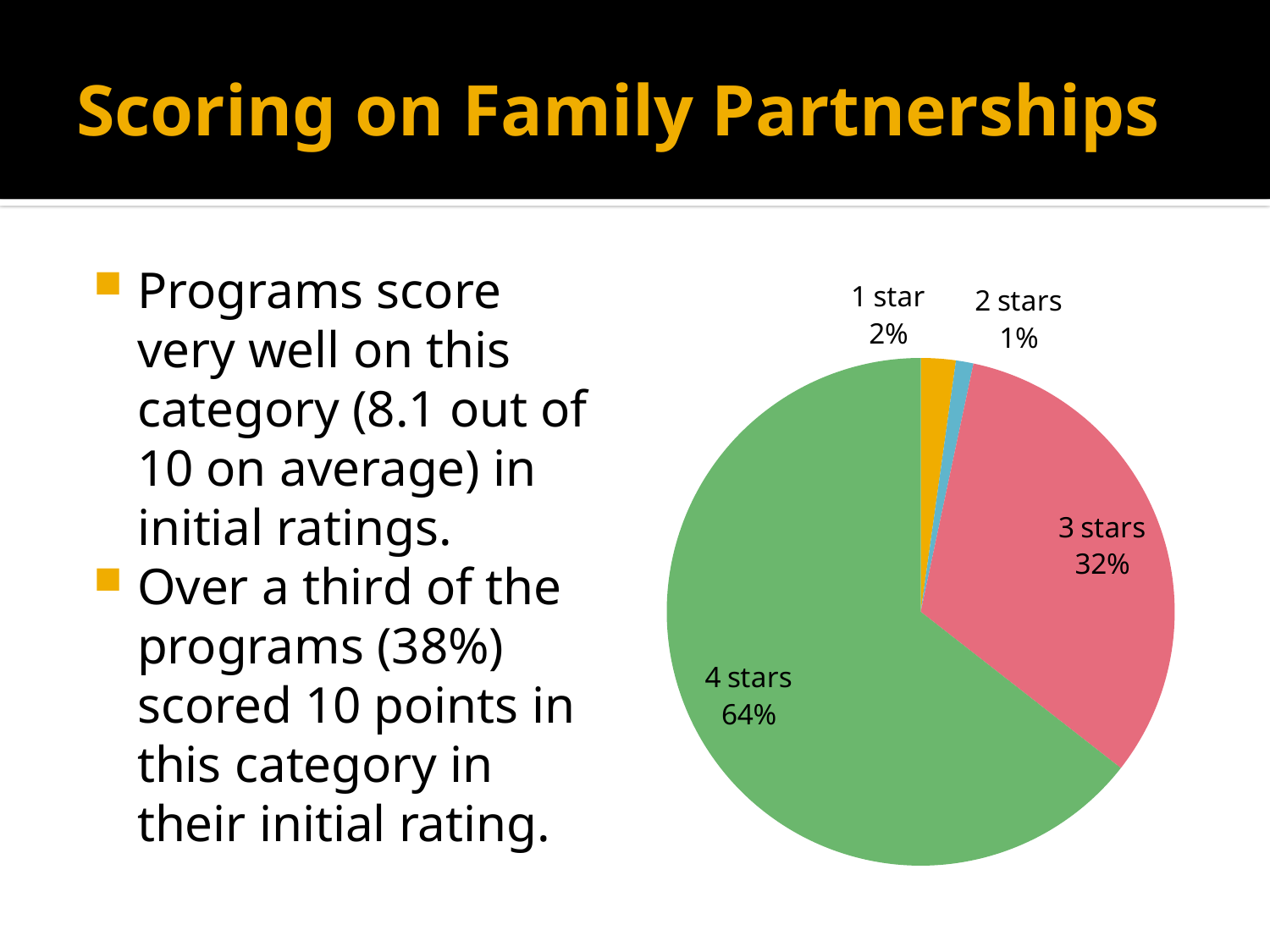
Which category has the smallest slice of the pie? 2 stars What colour is the 4 stars slice of the pie? green What kind of chart is shown on the slide? pie chart What share of the pie is labelled 3 stars? 32% What share of the pie is labelled 2 stars? 1% Which category has the largest slice of the pie? 4 stars What is the difference in percentage points between the 4 stars slice and the 3 stars slice? 32 What share of the pie is labelled 4 stars? 64% Which slice is larger, 1 star or 2 stars? 1 star What is the combined share of the 3 stars and 4 stars slices? 96% How many slices does the pie chart have? 4